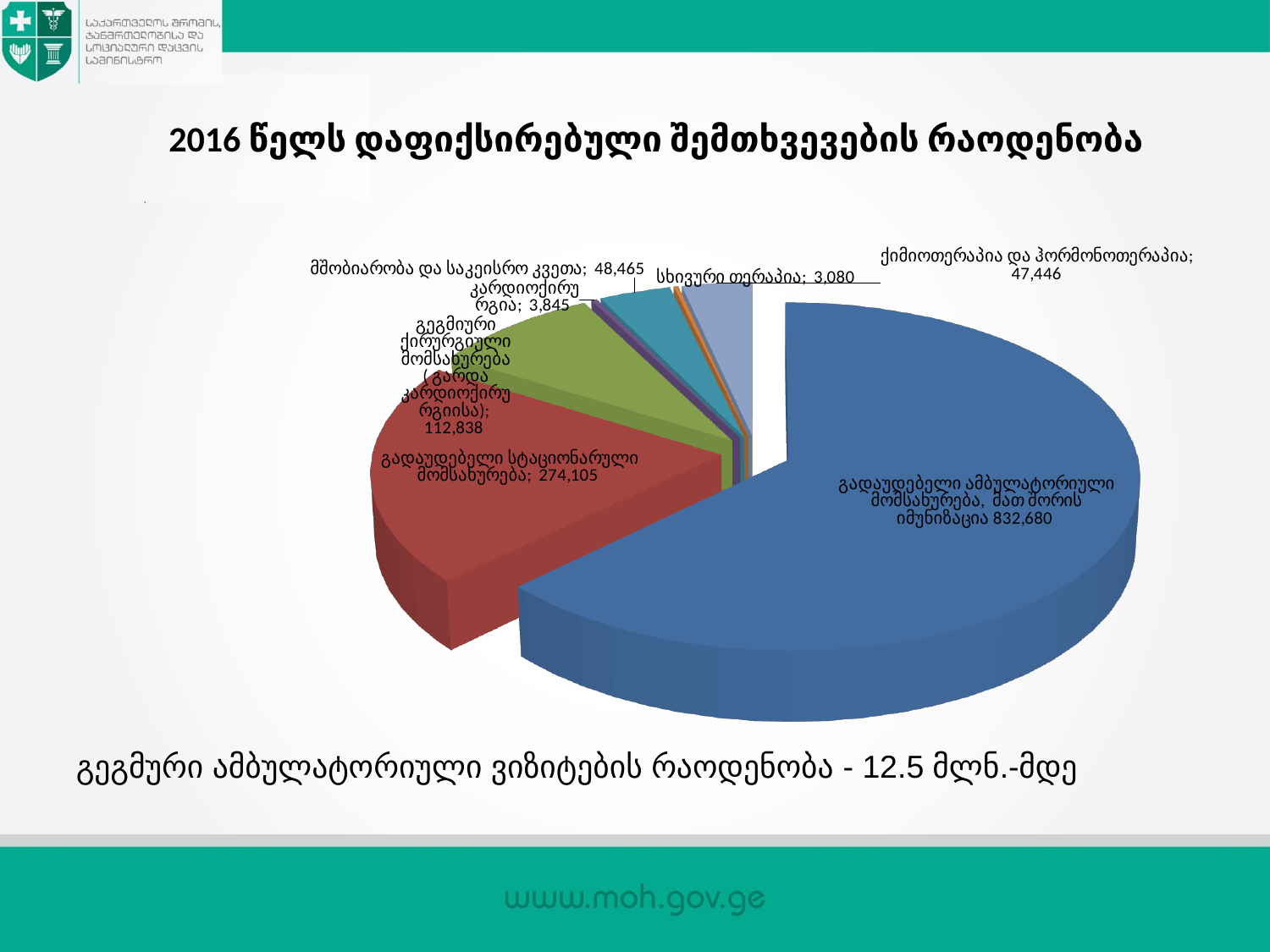
Which category has the largest slice of the pie? გადაუდებელი ამბულატორიული მომსახურება, მათ შორის იმუნიზაცია Which category has the smallest value in the pie chart? სხივური თერაპია How many slices does the pie chart have? 7 What is the value for გადაუდებელი ამბულატორიული მომსახურება, მათ შორის იმუნიზაცია? 832,680 What is the value for მშობიარობა და საკეისრო კვეთა? 48,465 What is the value for გადაუდებელი სტაციონარული მომსახურება? 274,105 What type of chart is shown on the slide? Pie chart What is the difference between გადაუდებელი სტაციონარული მომსახურება and გეგმიური ქირურგიული მომსახურება (გარდა კარდიოქირურგიისა)? 161,267 What is the title of the chart? 2016 წელს დაფიქსირებული შემთხვევების რაოდენობა What is the value for კარდიოქირურგია? 3,845 What is the value for სხივური თერაპია? 3,080 Which is larger: მშობიარობა და საკეისრო კვეთა or ქიმიოთერაპია და ჰორმონოთერაპია? მშობიარობა და საკეისრო კვეთა